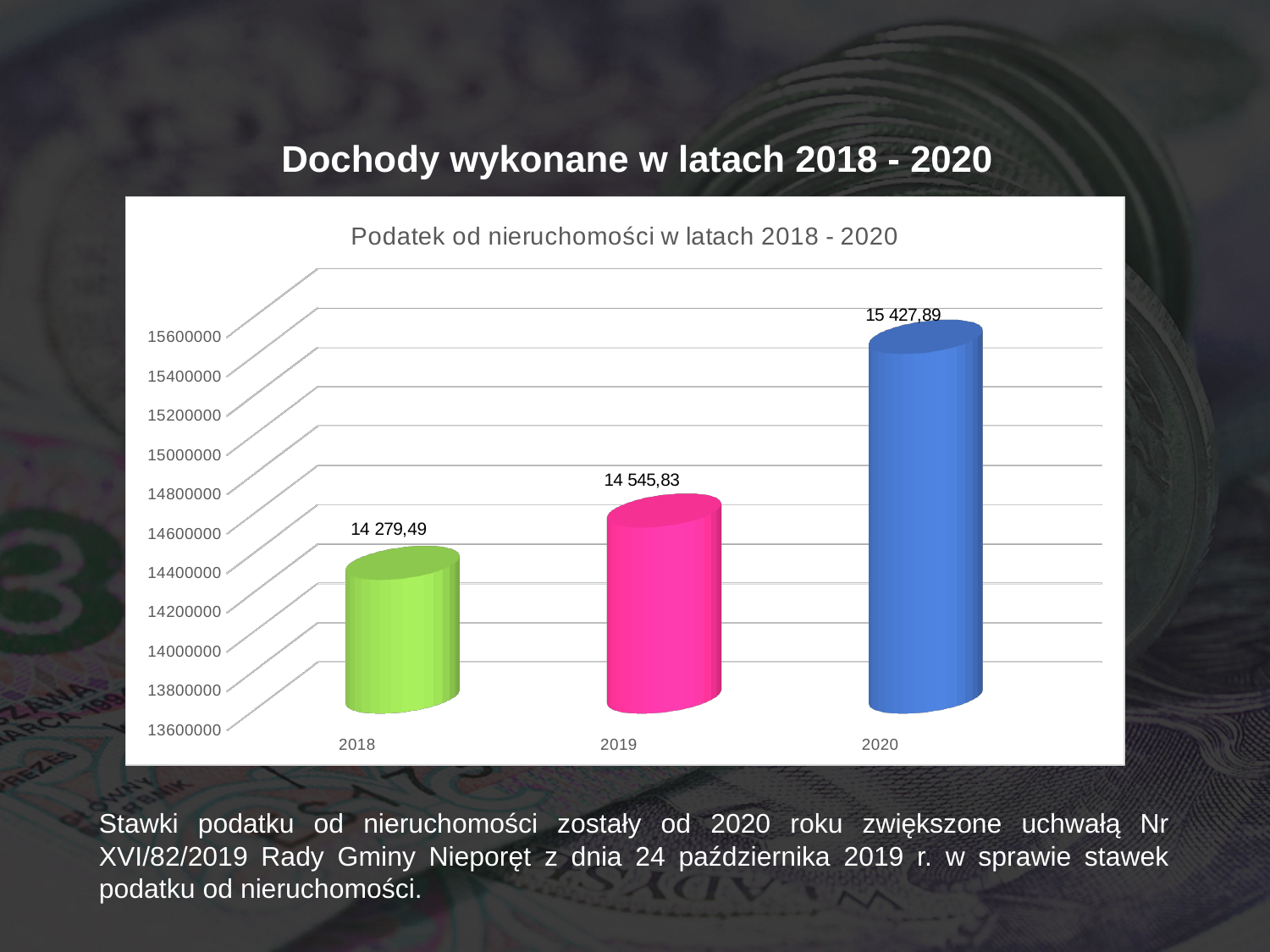
What kind of chart is this? bar chart Which year has the lowest value? 2018 What is the value shown for 2020? 15 427,89 What is the value shown for 2019? 14 545,83 Which is larger, the value for 2019 or the value for 2018? 2019 What is the value shown for 2018? 14 279,49 Which year has the highest value? 2020 What is the difference between the values for 2020 and 2019? 882,06 Is the bar for 2020 greater or less than 15000000 on the axis? greater How many years are shown on the x axis? 3 Do the values rise or fall from 2018 to 2020? rise What is the difference between the values for 2019 and 2018? 266,34